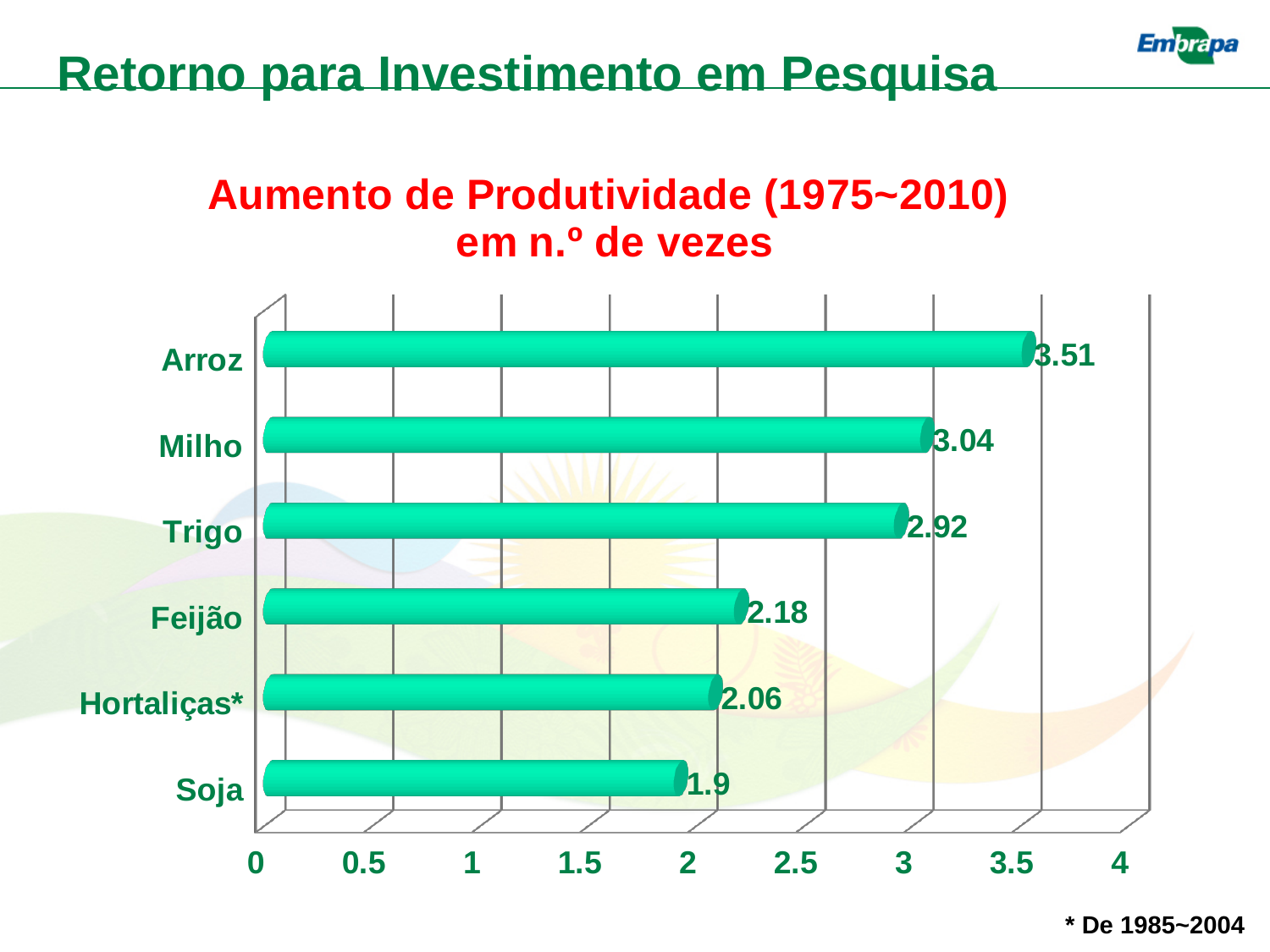
Is the value for Trigo greater or less than 3? less What is the value for Milho? 3.04 What is the value for Soja? 1.9 What is the value for Arroz? 3.51 What kind of chart is shown on the slide? bar chart Which category has the highest value? Arroz Which is larger, the value for Trigo or the value for Feijão? Trigo How many categories are shown in the chart? 6 What is the difference between the values for Arroz and Milho? 0.47 What is the value for Hortaliças*? 2.06 What is the difference between the values for Feijão and Soja? 0.28 Which category has the lowest value? Soja